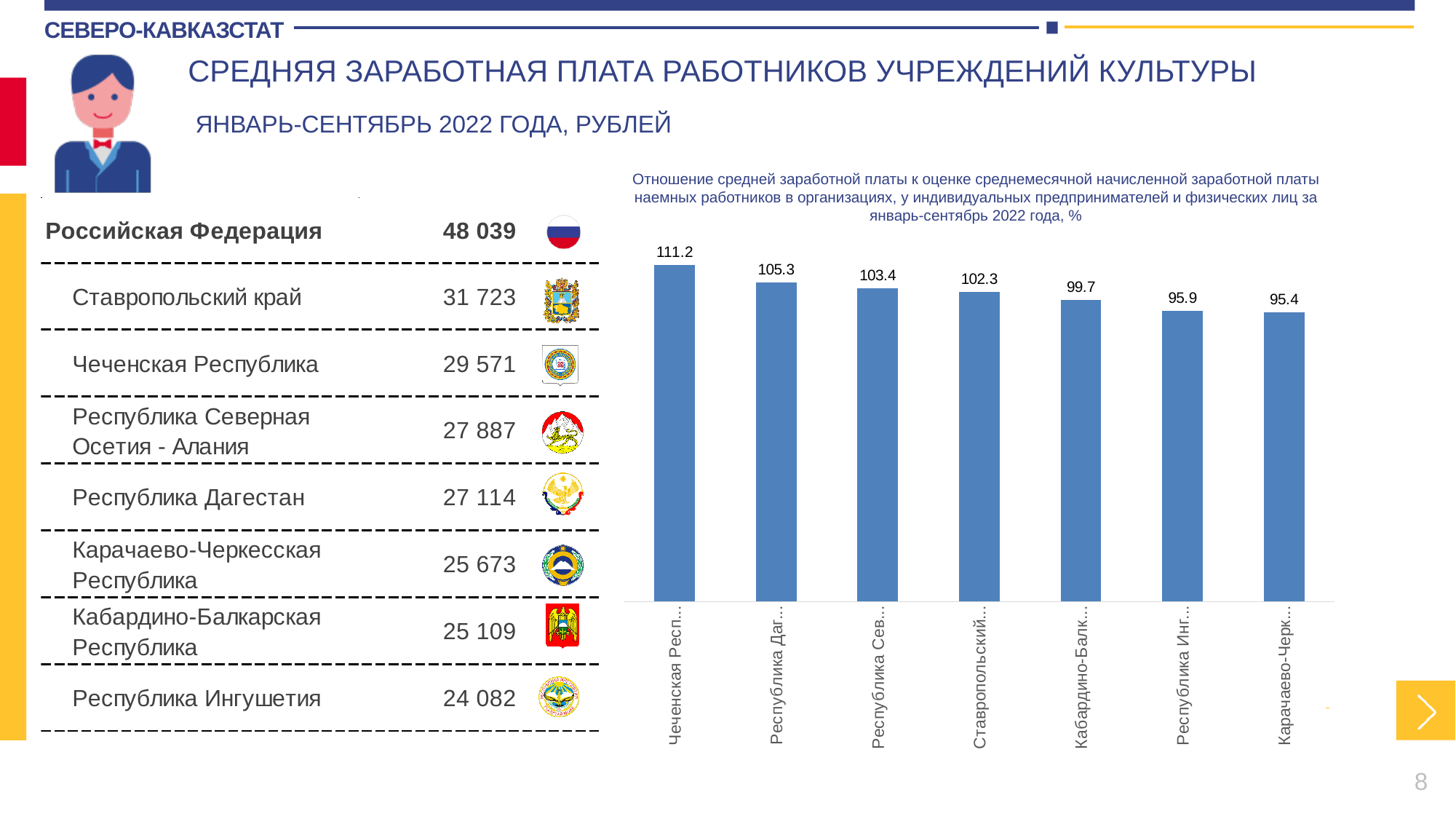
How many bars (regions) are plotted in the chart? 7 Do the values in the chart rise or fall from left to right? fall What is the value shown for Республика Дагестан in the chart? 105.3 What is the value shown for Чеченская Республика in the chart? 111.2 What is the value shown for Кабардино-Балкарская Республика in the chart? 99.7 What is the difference between the values for Чеченская Республика and Республика Дагестан in the chart? 5.9 What is the difference between the values for Республика Ингушетия and Карачаево-Черкесская Республика in the chart? 0.5 Which region has the highest value in the chart? Чеченская Республика Which region has the lowest value in the chart? Карачаево-Черкесская Республика What type of chart is shown on the right side of the slide? bar chart What is the value shown for Ставропольский край in the chart? 102.3 Which has a larger value in the chart, Республика Северная Осетия or Республика Ингушетия? Республика Северная Осетия